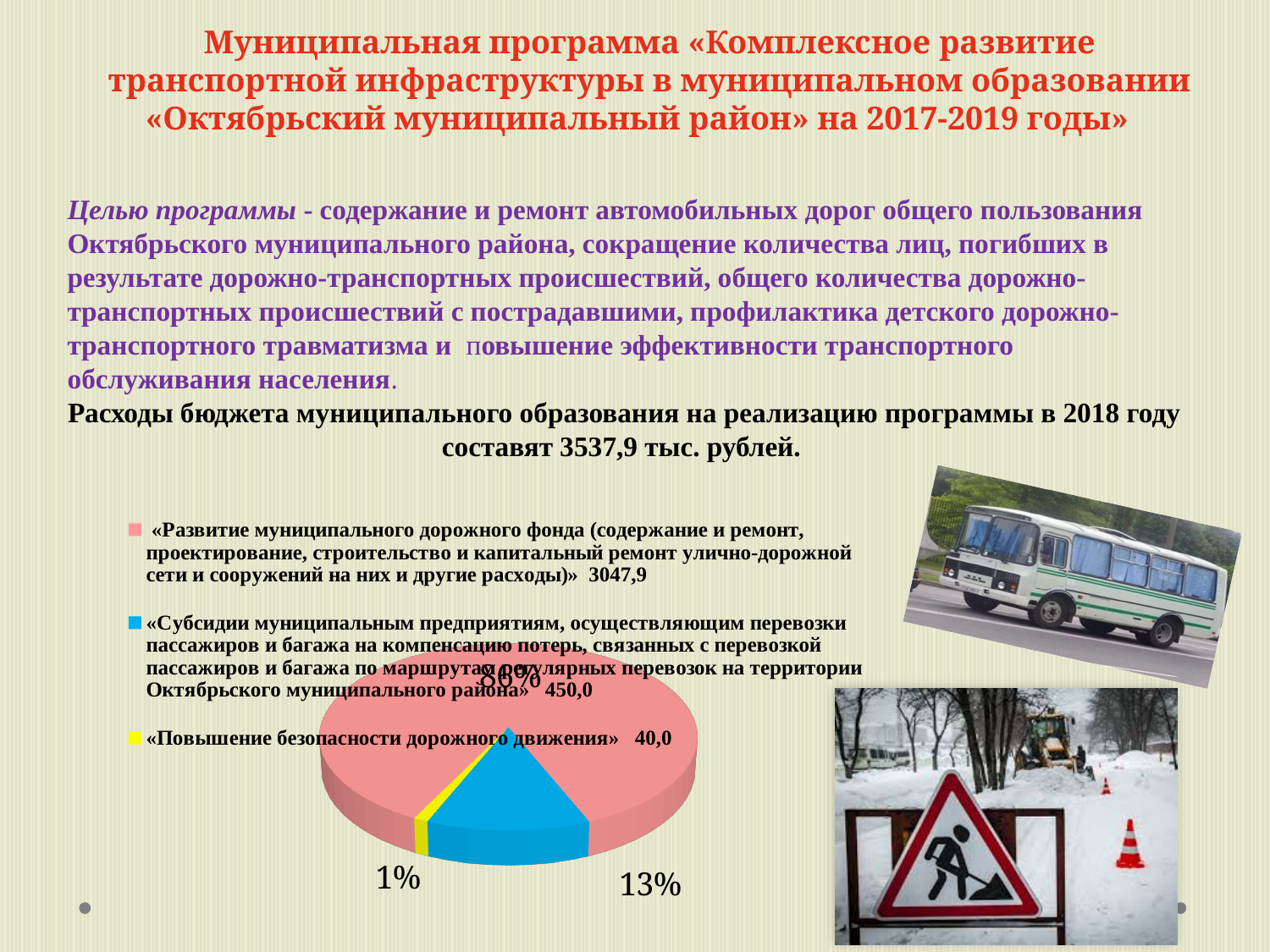
What kind of chart is shown on the slide? pie chart What is the difference between the legend values for «Субсидии муниципальным предприятиям...» (450,0) and «Повышение безопасности дорожного движения» (40,0)? 410,0 What value is given in the legend for «Повышение безопасности дорожного движения»? 40,0 How many slices does the pie chart have? 3 What share of the pie does «Субсидии муниципальным предприятиям, осуществляющим перевозки пассажиров и багажа...» take? 13% What colour is the slice for «Субсидии муниципальным предприятиям, осуществляющим перевозки пассажиров и багажа...»? blue How many entries does the legend of the pie chart list? 3 What share of the pie does «Развитие муниципального дорожного фонда...» take? 86% Which legend category has the largest slice of the pie? «Развитие муниципального дорожного фонда (содержание и ремонт, проектирование, строительство и капитальный ремонт улично-дорожной сети и сооружений на них и другие расходы)» Which legend category has the smallest slice of the pie? «Повышение безопасности дорожного движения» What share of the pie does «Повышение безопасности дорожного движения» take? 1% What value is given in the legend for «Субсидии муниципальным предприятиям, осуществляющим перевозки пассажиров и багажа...»? 450,0